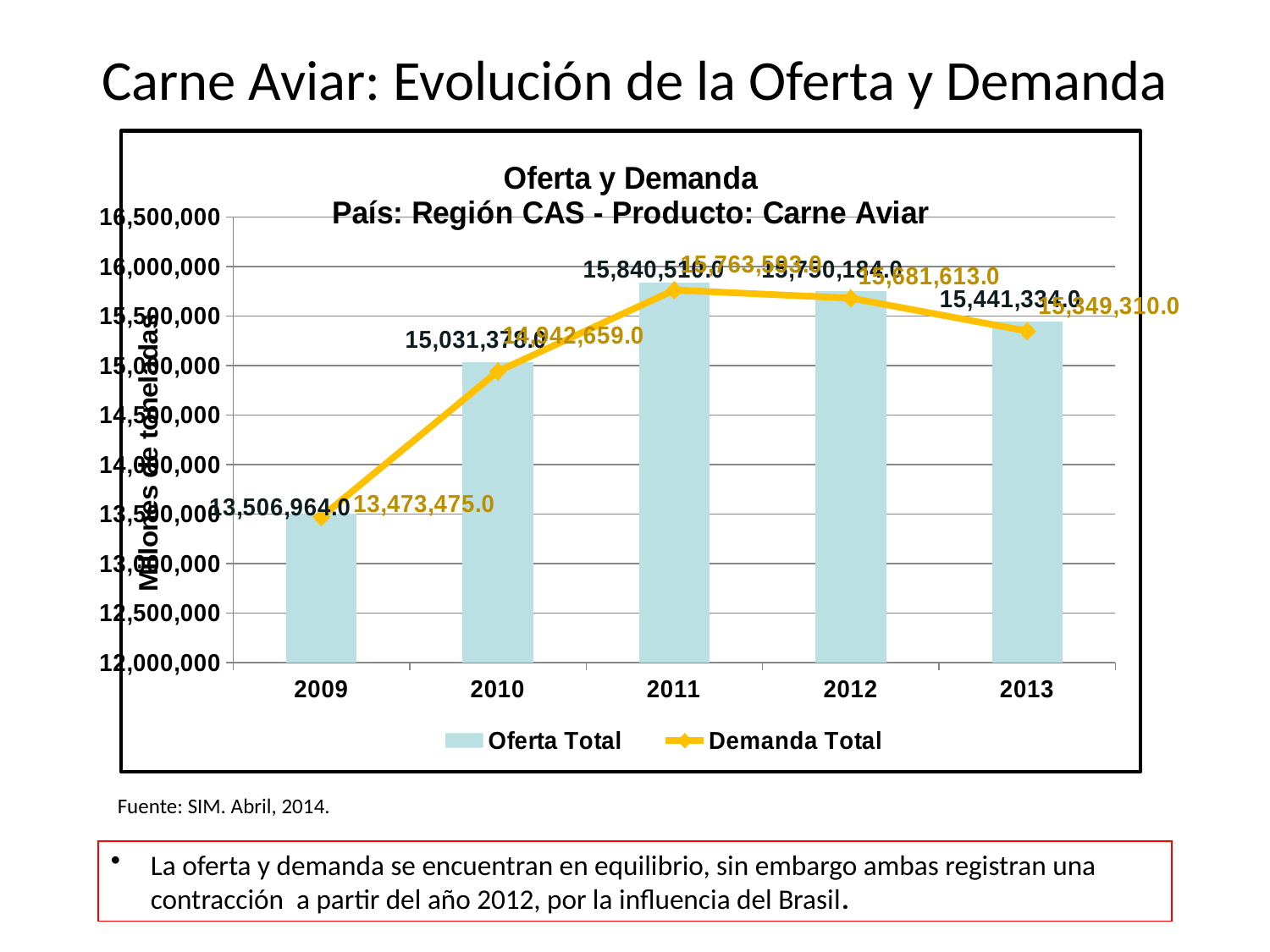
What is the Demanda Total value for 2012? 15,681,613.0 What is the Demanda Total value for 2013? 15,349,310.0 In which year is Demanda Total lowest? 2009 What kind of chart is shown on the slide? A combined bar and line chart In 2010, which is larger: Oferta Total or Demanda Total? Oferta Total Does Demanda Total rise or fall from 2011 to 2013? Fall How many series does the legend list? 2 Is the Oferta Total value for 2013 greater or less than 15,000,000? greater What is the difference between Oferta Total and Demanda Total in 2009? 33,489.0 How many years are shown on the x axis? 5 In which year is Oferta Total highest? 2011 What is the Oferta Total value for 2009? 13,506,964.0